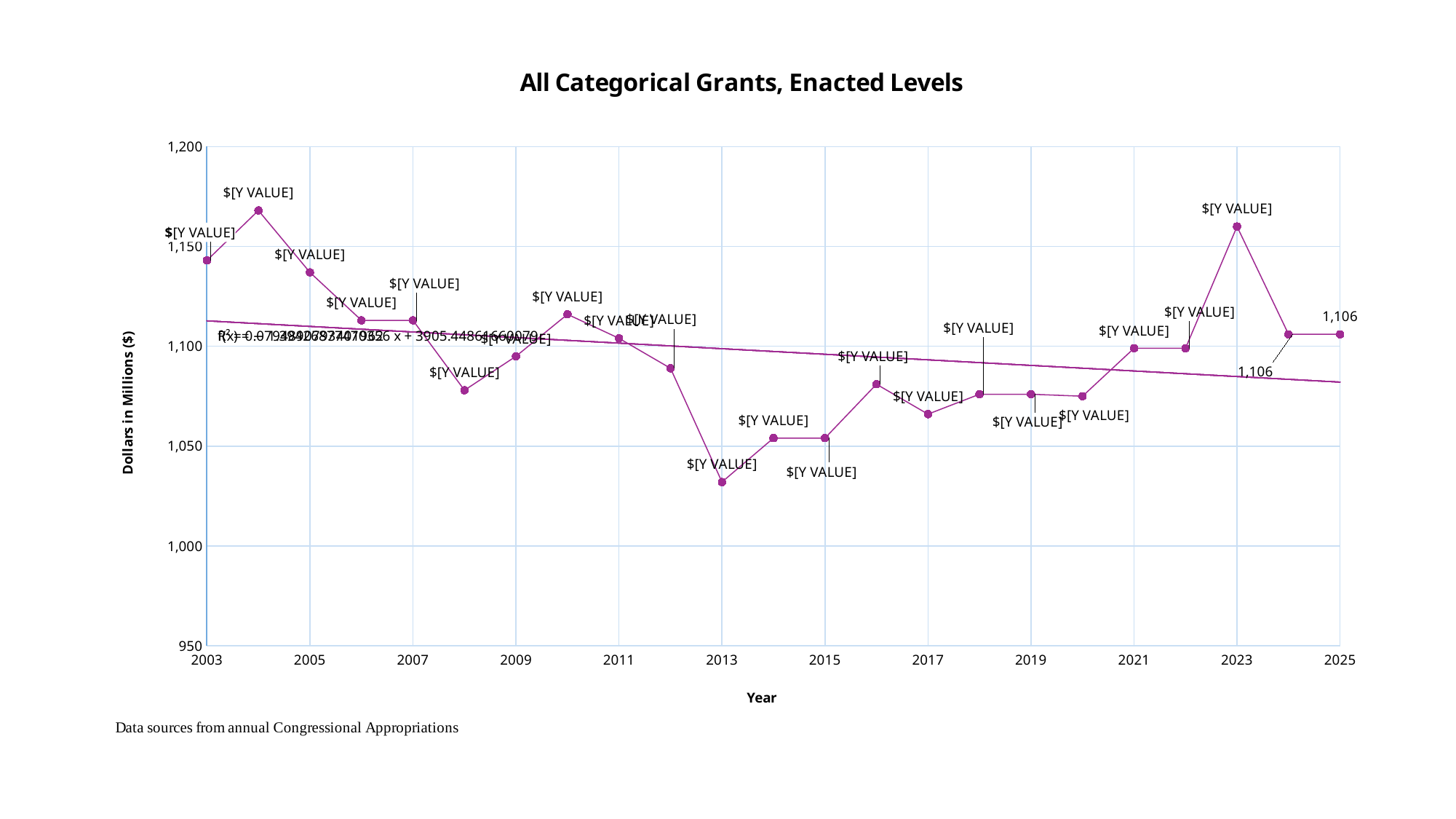
What type of chart is shown on the slide? line chart Which year has the lowest value? 2013 Which is larger, the value for 2010 or the value for 2013? 2010 Is the value for 2013 greater or less than 1,050? less Is the value for 2023 greater or less than 1,150? greater What is the value for 2025? 1,106 What is the label on the vertical axis of the chart? Dollars in Millions ($) Is the value for 2008 greater or less than 1,100? less How many years are plotted on the x axis from 2003 to 2025? 23 What is the value for 2024? 1,106 What is the title of the chart? All Categorical Grants, Enacted Levels